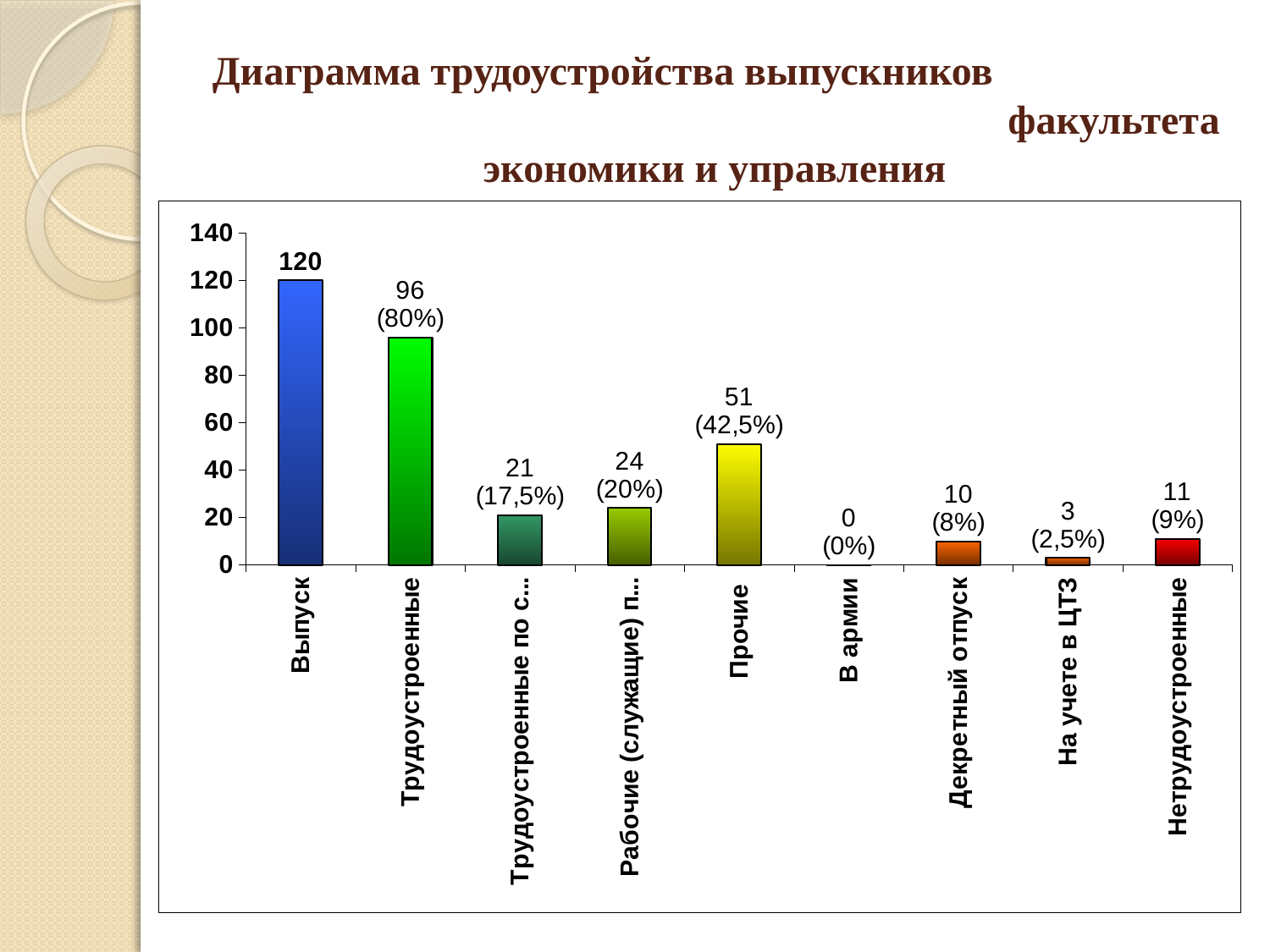
Which category has the lowest value? В армии What is the value for Декретный отпуск? 10 What is the value for На учете в ЦТЗ? 3 What percentage is shown for Нетрудоустроенные? 9% What type of chart is shown on the slide? bar chart How many categories are shown on the x axis of the chart? 9 Which category has the highest value? Выпуск What is the difference between the values for Выпуск and Трудоустроенные? 24 What percentage is shown for Прочие? 42,5% What is the value for Выпуск? 120 Which is larger, the value for Нетрудоустроенные or the value for Декретный отпуск? Нетрудоустроенные What is the value for Трудоустроенные? 96